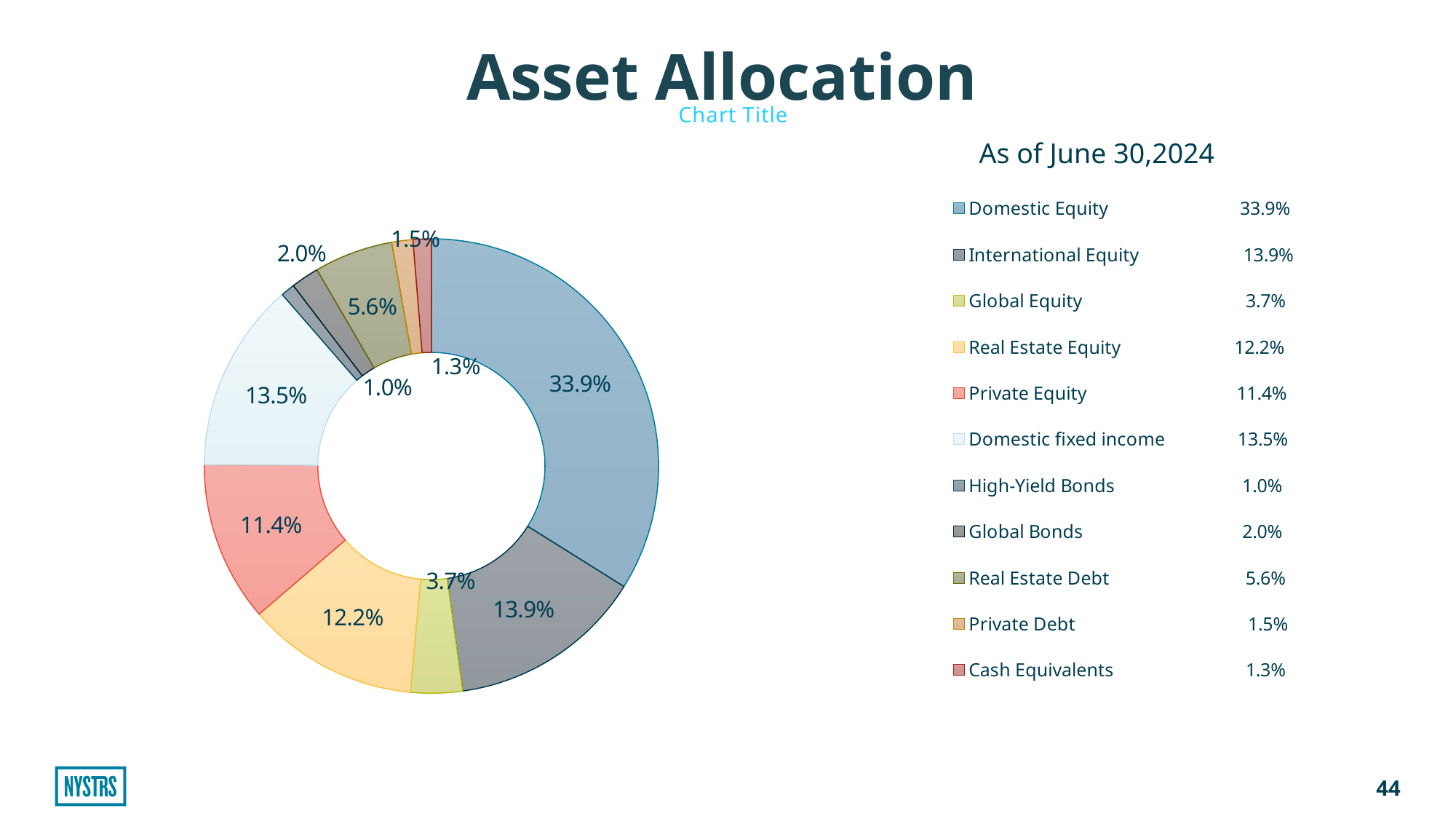
Which is larger, the Real Estate Equity share or the Private Equity share? Real Estate Equity How many asset classes are shown in the chart? 11 Which asset class has the smallest share of the allocation? High-Yield Bonds What is the difference between the Domestic fixed income share and the Private Equity share? 2.1% What date is the asset allocation reported as of? June 30, 2024 What share of the asset allocation is Domestic fixed income? 13.5% Which asset class has the largest share of the allocation? Domestic Equity What share of the asset allocation is Domestic Equity? 33.9% What is the difference between the Domestic Equity share and the International Equity share? 20.0% What is the combined share of Global Bonds and Private Debt? 3.5% What kind of chart is shown on the slide? Pie chart (doughnut) What share of the asset allocation is Real Estate Debt? 5.6%